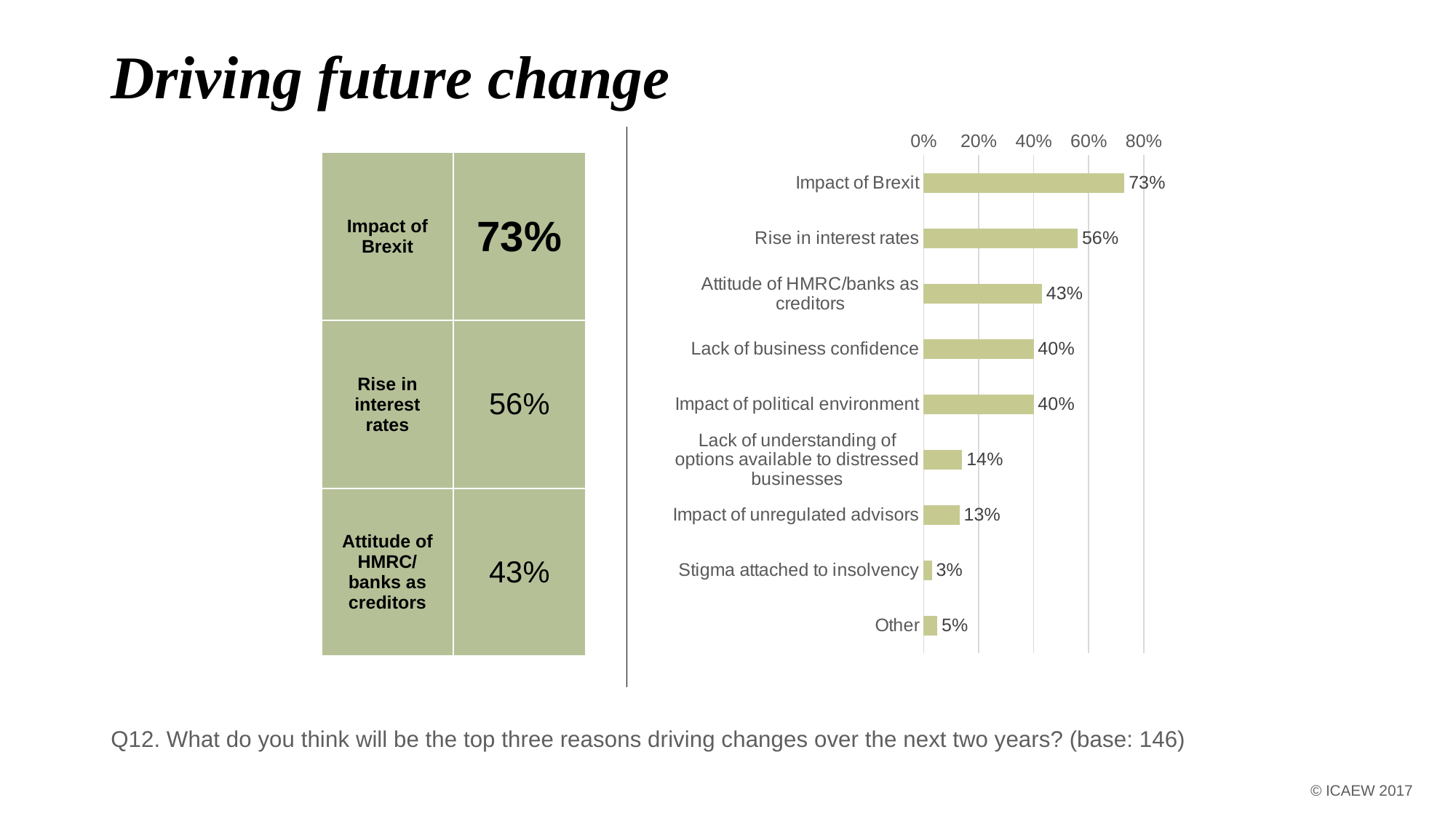
What is the value for Stigma attached to insolvency? 3% What is the value for Impact of Brexit? 73% What is the value for Impact of unregulated advisors? 13% What is the value for Rise in interest rates? 56% Is the value for Impact of political environment greater or less than 60%? less What is the difference between Impact of Brexit and Rise in interest rates? 17% What is the value for Other? 5% Which category has the highest value? Impact of Brexit What kind of chart is shown? bar chart How many categories are shown in the chart? 9 Which category has the lowest value? Stigma attached to insolvency Which is larger, Attitude of HMRC/banks as creditors or Lack of business confidence? Attitude of HMRC/banks as creditors